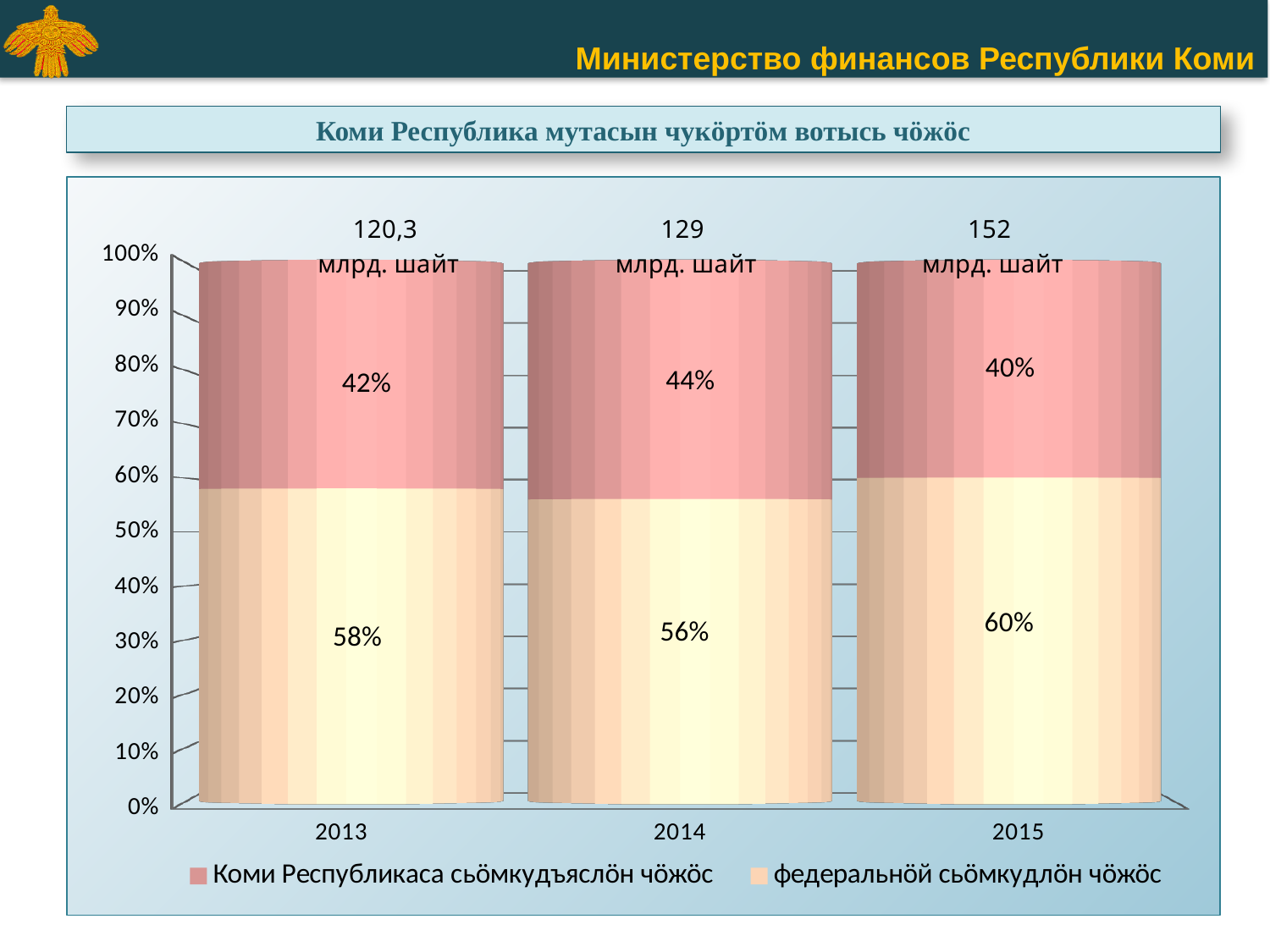
How many years are shown on the x axis? 3 How many series does the legend list? 2 What is the value for Коми Республикаса сьӧмкудъяслӧн чӧжӧс in 2015? 40% What kind of chart is shown on the slide? Stacked bar chart Which is larger in 2013: the share of Коми Республикаса сьӧмкудъяслӧн чӧжӧс or the share of федеральнӧй сьӧмкудлӧн чӧжӧс? федеральнӧй сьӧмкудлӧн чӧжӧс What is the difference between the федеральнӧй сьӧмкудлӧн чӧжӧс share in 2015 and in 2014? 4% What is the value for Коми Республикаса сьӧмкудъяслӧн чӧжӧс in 2014? 44% What is the value for федеральнӧй сьӧмкудлӧн чӧжӧс in 2013? 58% What total amount is printed above the 2013 bar? 120,3 млрд. шайт What total amount is printed above the 2015 bar? 152 млрд. шайт In which year is the share of федеральнӧй сьӧмкудлӧн чӧжӧс highest? 2015 In which year is the share of Коми Республикаса сьӧмкудъяслӧн чӧжӧс lowest? 2015